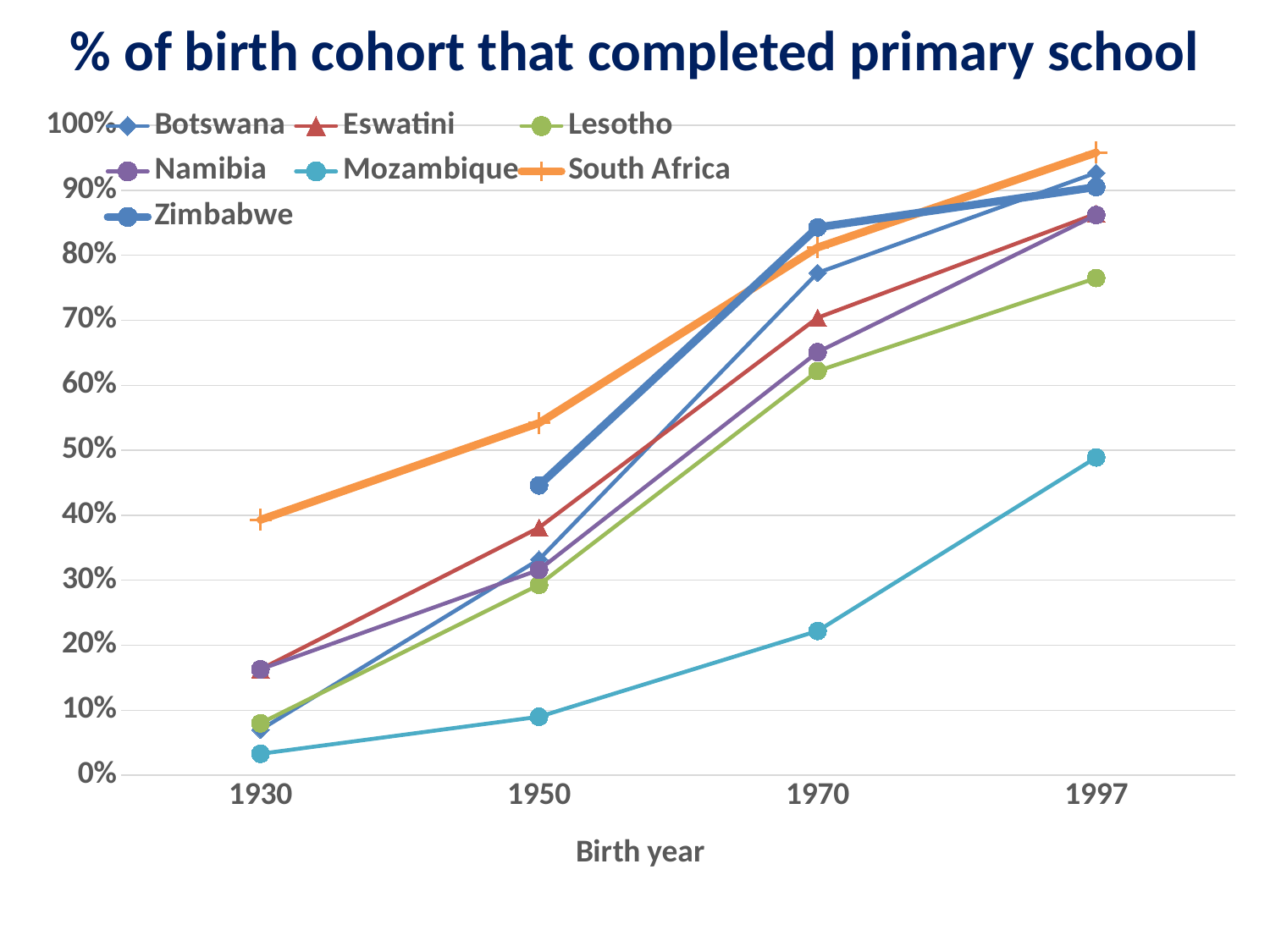
Do the values for South Africa rise or fall from 1930 to 1997? rise What kind of chart is shown on the slide? line chart Is the value for Zimbabwe in 1950 greater or less than 40%? greater Which is larger for the 1970 birth cohort, Botswana or Lesotho? Botswana Is the value for South Africa in 1930 greater or less than 30%? greater Which country has the lowest value for the 1997 birth cohort? Mozambique Is the value for Mozambique in 1997 greater or less than 50%? less How many birth years are shown on the x axis? 4 Which country has the highest value for the 1930 birth cohort? South Africa What is the title of the x axis? Birth year How many countries (series) does the legend list? 7 Which country has the highest value for the 1997 birth cohort? South Africa